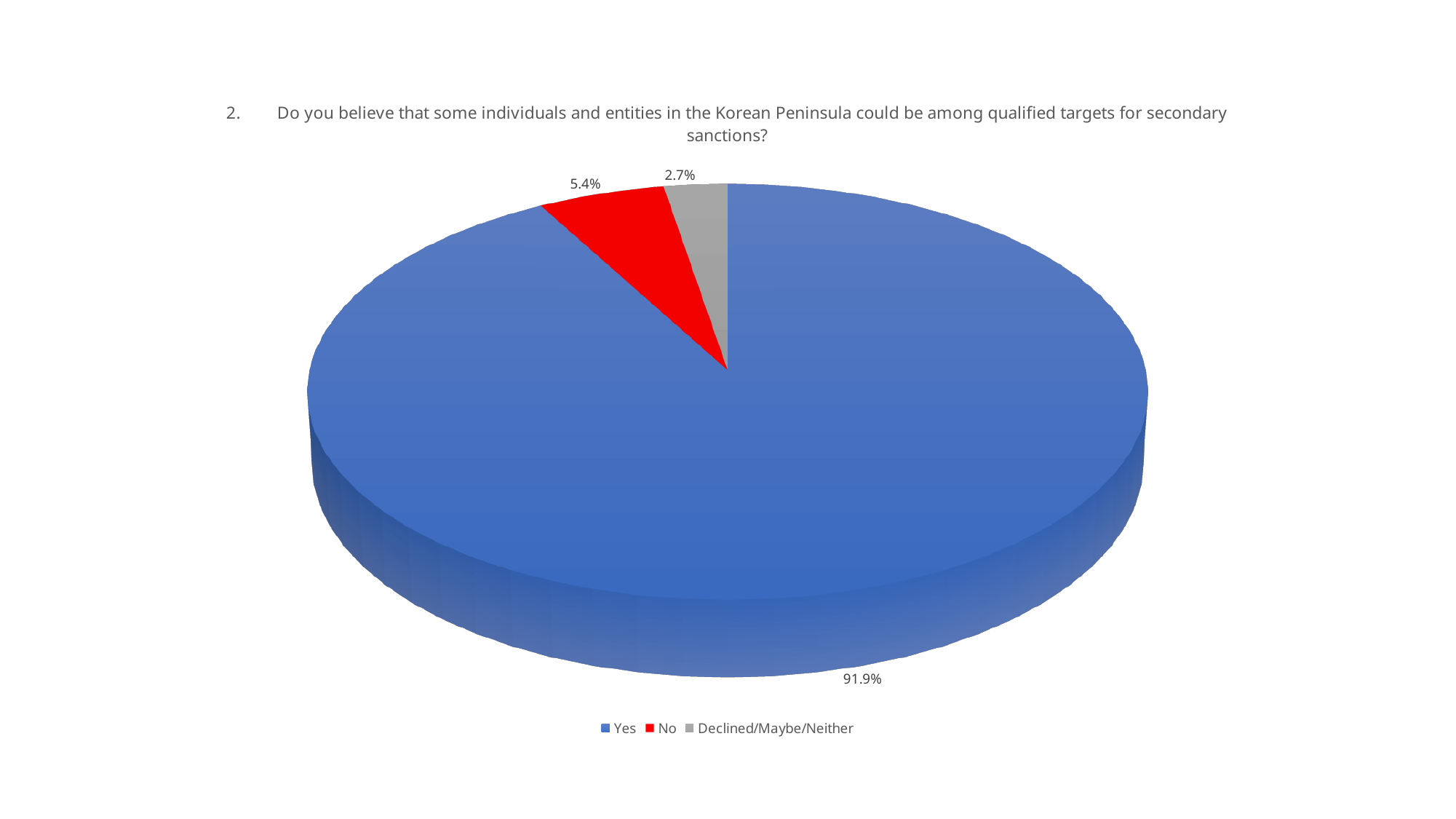
Which response category has the largest share of the pie? Yes What is the difference in percentage points between the 'Yes' and 'No' shares? 86.5 Which response category has the smallest share of the pie? Declined/Maybe/Neither What is the difference in percentage points between the 'No' and 'Declined/Maybe/Neither' shares? 2.7 How many categories does the legend list? 3 What is the combined share of 'No' and 'Declined/Maybe/Neither'? 8.1% What share of responses is 'Declined/Maybe/Neither'? 2.7% What kind of chart is shown on the slide? Pie chart What colour is the 'No' slice? Red What share of responses is 'No'? 5.4% Which is larger, the share for 'No' or the share for 'Declined/Maybe/Neither'? No What share of responses is 'Yes'? 91.9%